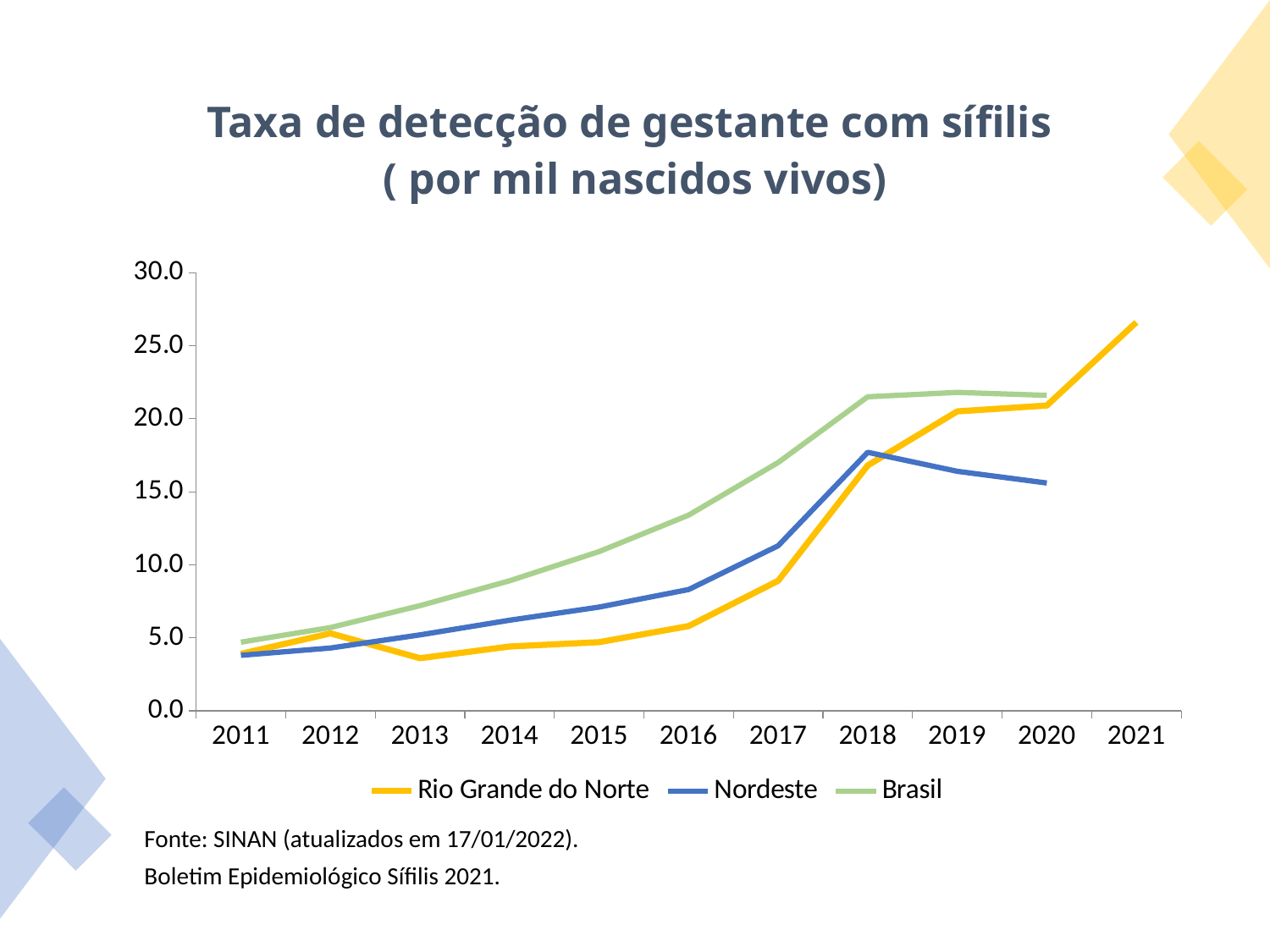
Is the value for Rio Grande do Norte in 2013 greater or less than 5.0? less Which series is drawn in green? Brasil How many years are shown on the x axis? 11 Which series has the highest value in 2018? Brasil Which series has the lowest value in 2015? Rio Grande do Norte Is the value for Rio Grande do Norte in 2021 greater or less than 25.0? greater How many series does the legend list? 3 What kind of chart is shown on the slide? Line chart In 2020, which is larger: the value for Rio Grande do Norte or the value for Nordeste? Rio Grande do Norte Is the value for Nordeste in 2017 greater or less than 10.0? greater Does the Nordeste line rise or fall from 2018 to 2020? Fall